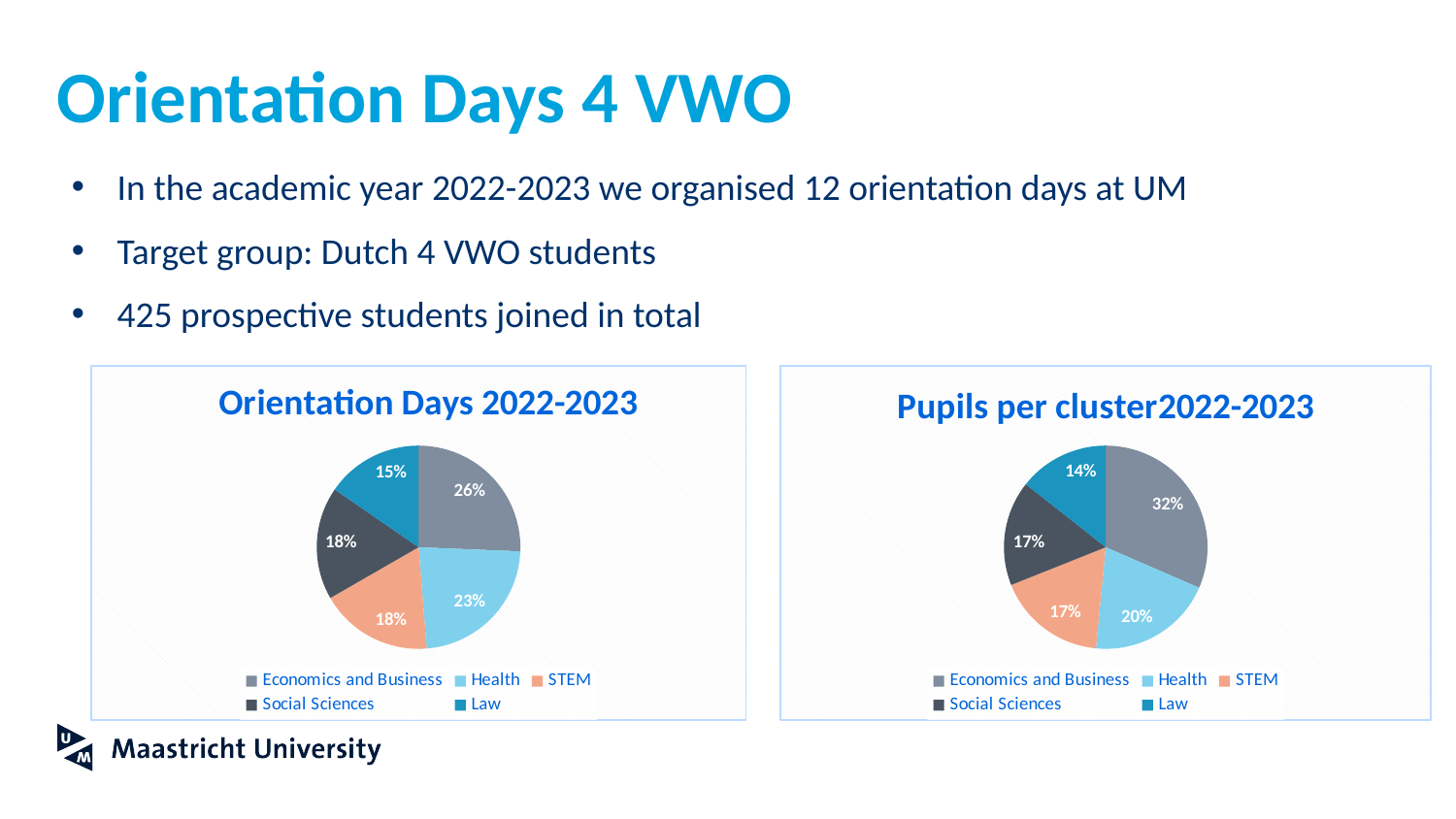
In the 'Pupils per cluster2022-2023' pie chart, which is larger, the Health share or the STEM share? Health In the 'Pupils per cluster2022-2023' pie chart, what share does Economics and Business have? 32% In the 'Orientation Days 2022-2023' pie chart, what share does Economics and Business have? 26% In the 'Pupils per cluster2022-2023' pie chart, what share does Law have? 14% In the 'Pupils per cluster2022-2023' pie chart, what is the difference between the Economics and Business share and the Health share? 12% In the 'Orientation Days 2022-2023' pie chart, what is the difference between the Health share and the Law share? 8% In the 'Pupils per cluster2022-2023' pie chart, which cluster has the largest share? Economics and Business In the 'Orientation Days 2022-2023' pie chart, which cluster has the largest share? Economics and Business What type of chart is the 'Pupils per cluster2022-2023' chart? Pie chart How many slices does the 'Orientation Days 2022-2023' pie chart have? 5 In the 'Orientation Days 2022-2023' pie chart, which cluster has the smallest share? Law